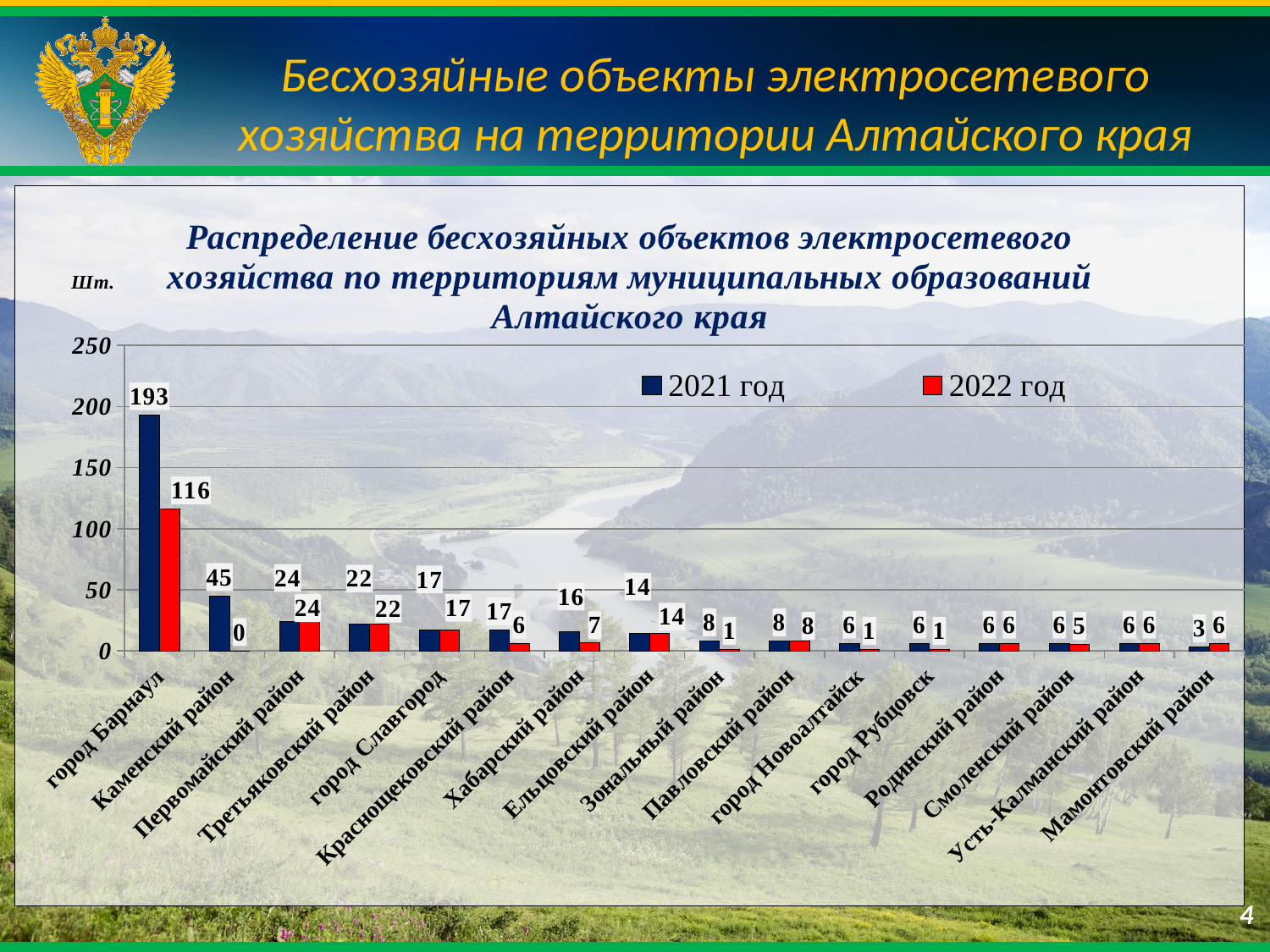
What is the 2021 год value for Хабарский район? 16 Which category has the lowest 2021 год value? Мамонтовский район Which category has the highest 2021 год value? город Барнаул What kind of chart is shown on the slide? bar chart What is the value for город Барнаул in the 2021 год series? 193 What is the difference between the 2021 год and 2022 год values for город Барнаул? 77 How many categories are shown on the x axis? 16 What is the value for город Барнаул in the 2022 год series? 116 What is the difference between the 2021 год and 2022 год values for Краснощековский район? 11 How many series does the legend list? 2 Which is larger for Мамонтовский район: the 2021 год value or the 2022 год value? 2022 год What is the 2022 год value for Каменский район? 0